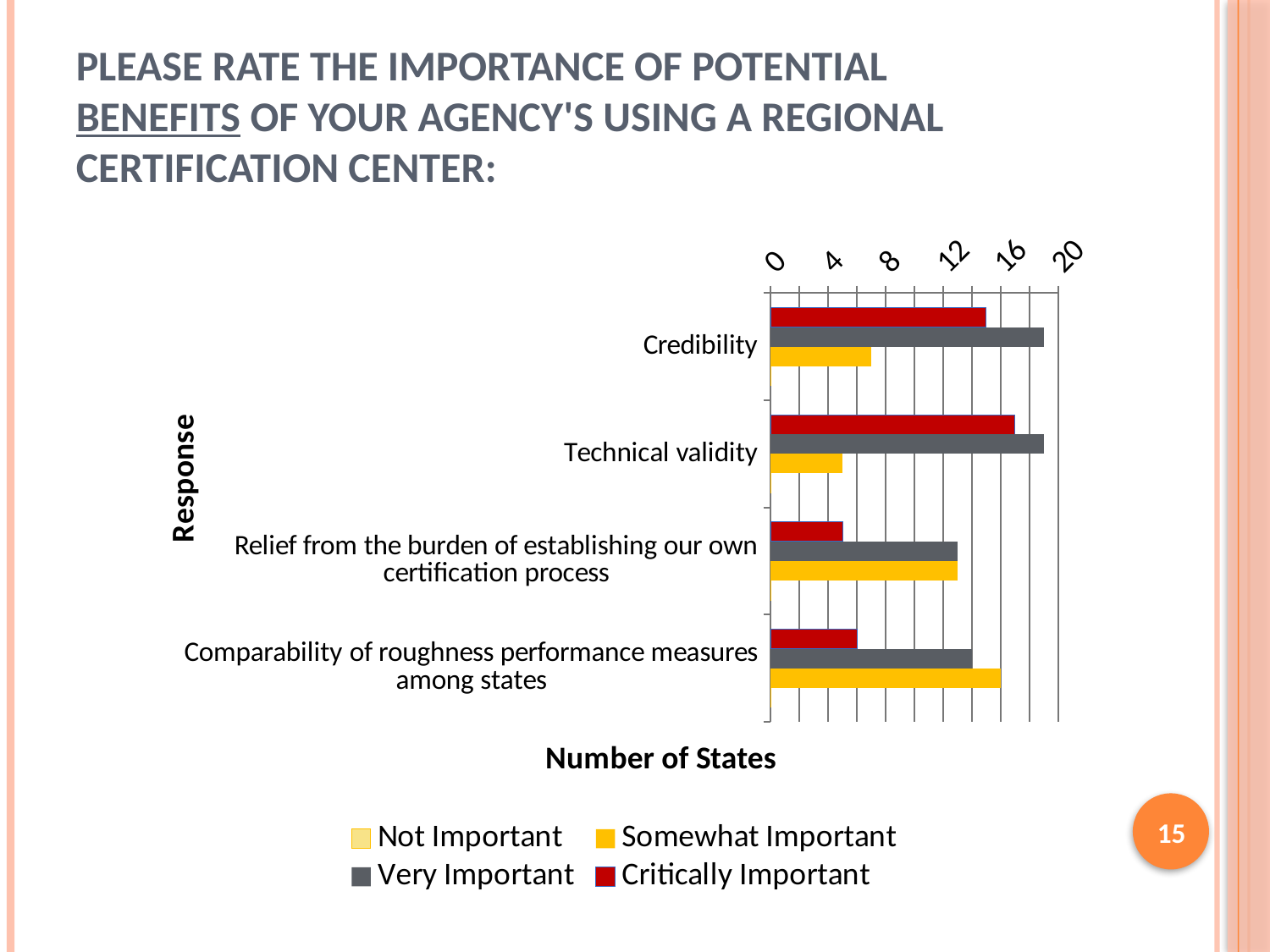
How many series does the chart's legend list? 4 Is the Very Important value for Credibility greater or less than 16? greater Is the Somewhat Important value for Comparability of roughness performance measures among states greater or less than 12? greater What kind of chart is shown on the slide? bar chart Which response category has the highest Somewhat Important value? Comparability of roughness performance measures among states Is the Somewhat Important value for Credibility greater or less than 12? less For Credibility, which is larger: the Very Important value or the Somewhat Important value? Very Important What is the title of the horizontal axis of the chart? Number of States How many response categories are shown on the y axis of the chart? 4 What is the title of the vertical axis of the chart? Response